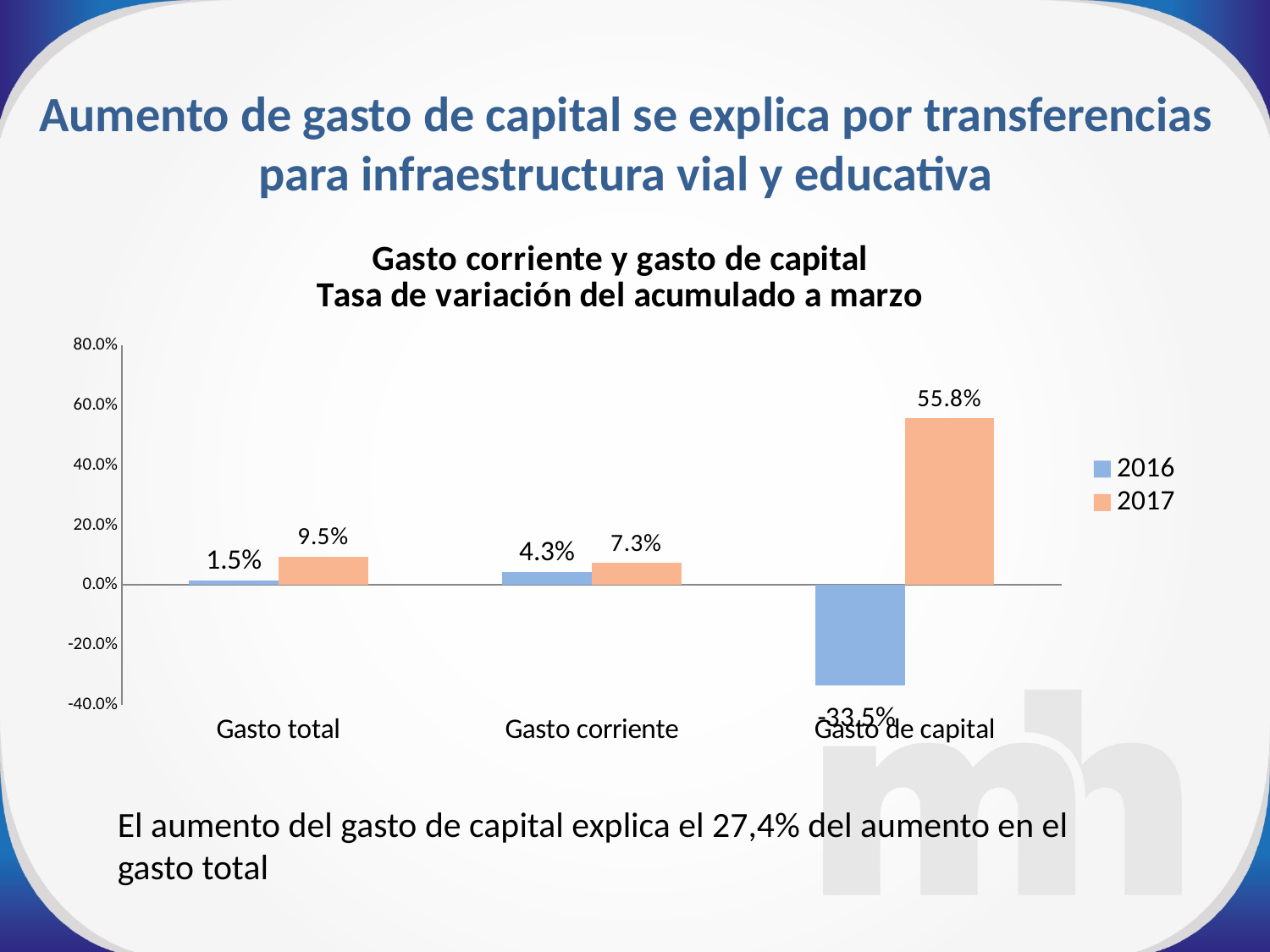
What is the 2016 value for Gasto de capital? -33.5% Which is larger for Gasto corriente, the 2016 value or the 2017 value? 2017 How many categories are shown on the x axis? 3 What is the 2016 value for Gasto corriente? 4.3% What is the difference between the 2017 and 2016 values for Gasto total? 8.0% What is the 2016 value for Gasto total? 1.5% What is the 2017 value for Gasto corriente? 7.3% What kind of chart is shown on the slide? bar chart How many series does the legend list? 2 What is the 2017 value for Gasto de capital? 55.8% Which category has the lowest 2016 value? Gasto de capital Which category has the highest 2017 value? Gasto de capital